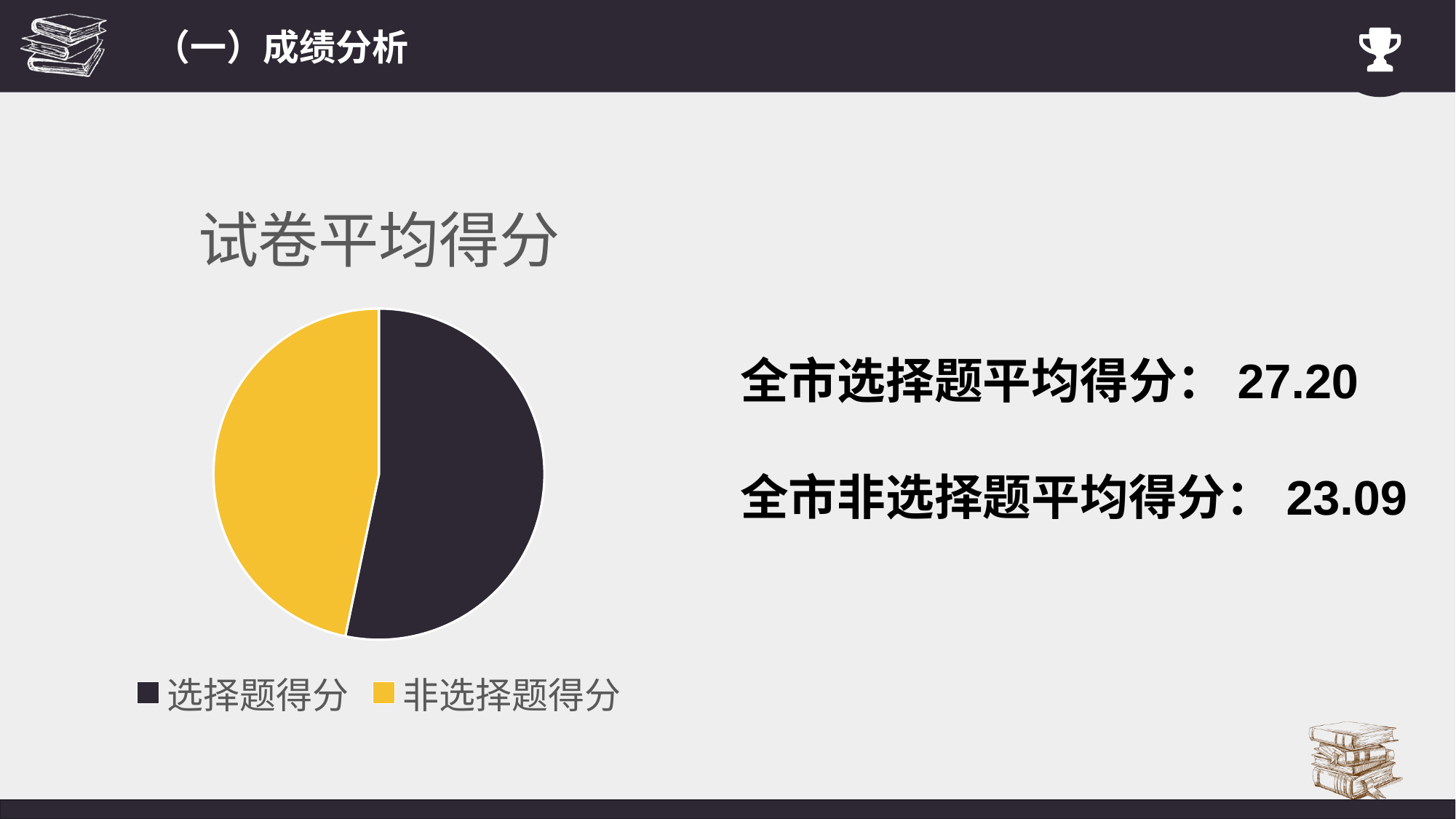
Does the 选择题得分 slice take up more or less than half of the pie chart? more What is the title of the pie chart? 试卷平均得分 Which slice of the pie chart is the largest? 选择题得分 What is the city-wide average score for 选择题 shown on the slide? 27.20 How many entries does the legend of the pie chart list? 2 What is the difference between the 选择题 average score (27.20) and the 非选择题 average score (23.09)? 4.11 What is the city-wide average score for 非选择题 shown on the slide? 23.09 Which is larger, the 选择题得分 slice or the 非选择题得分 slice? 选择题得分 Which colour represents 非选择题得分 in the pie chart? yellow How many slices does the pie chart have? 2 Which slice of the pie chart is the smallest? 非选择题得分 What kind of chart is shown on the slide? pie chart